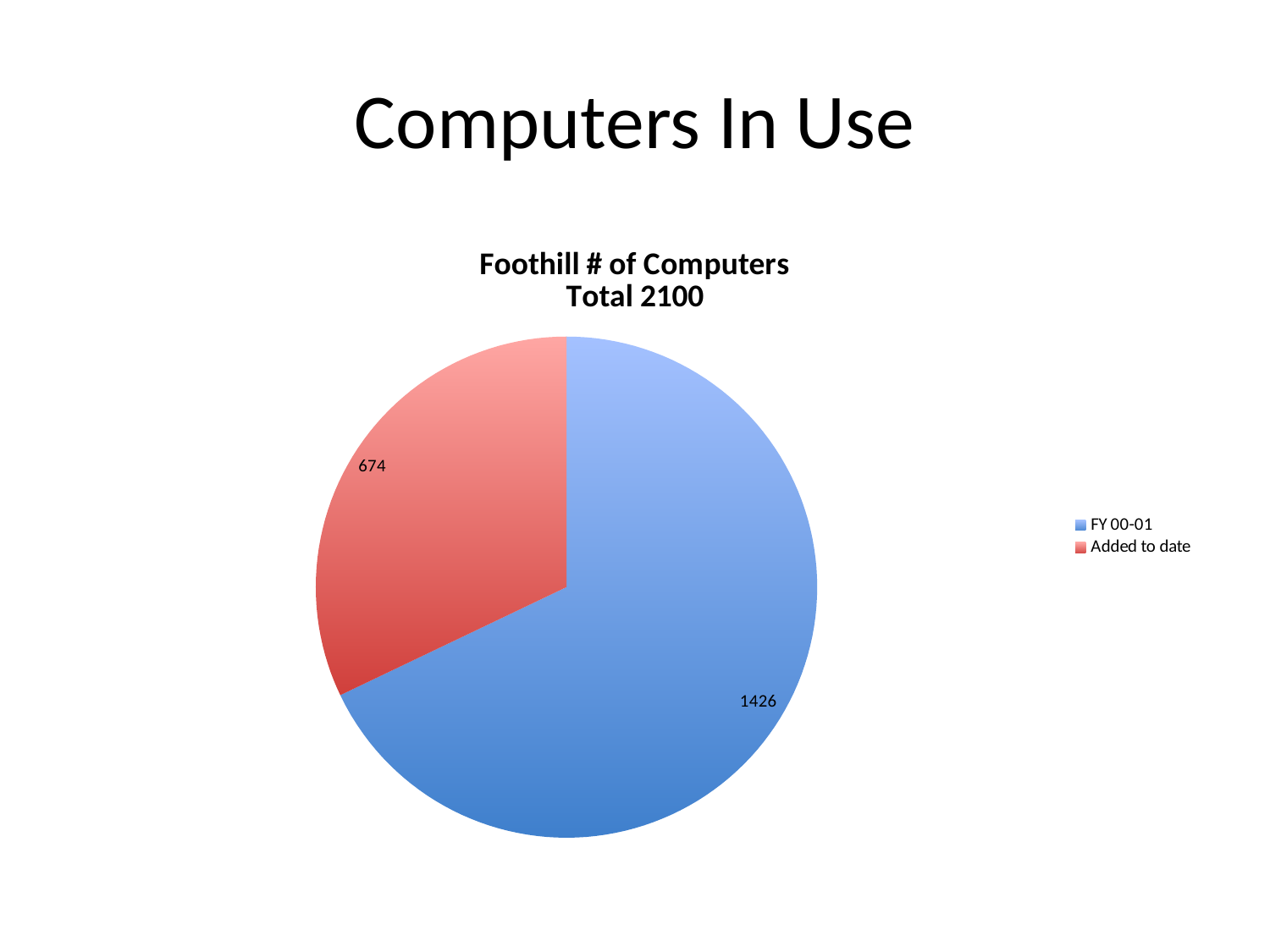
What kind of chart is shown on the slide? Pie chart Which slice of the pie chart is the smallest? Added to date What is the value of the FY 00-01 slice in the pie chart? 1426 What is the total of the two slices in the pie chart? 2100 How many entries does the legend list? 2 What is the difference between the FY 00-01 value and the Added to date value? 752 What is the title of the chart? Foothill # of Computers Total 2100 Which is larger, FY 00-01 or Added to date? FY 00-01 What is the value of the Added to date slice in the pie chart? 674 Which slice of the pie chart is the largest? FY 00-01 What share of the pie does the Added to date slice represent, to one decimal place? 32.1% How many slices does the pie chart have? 2